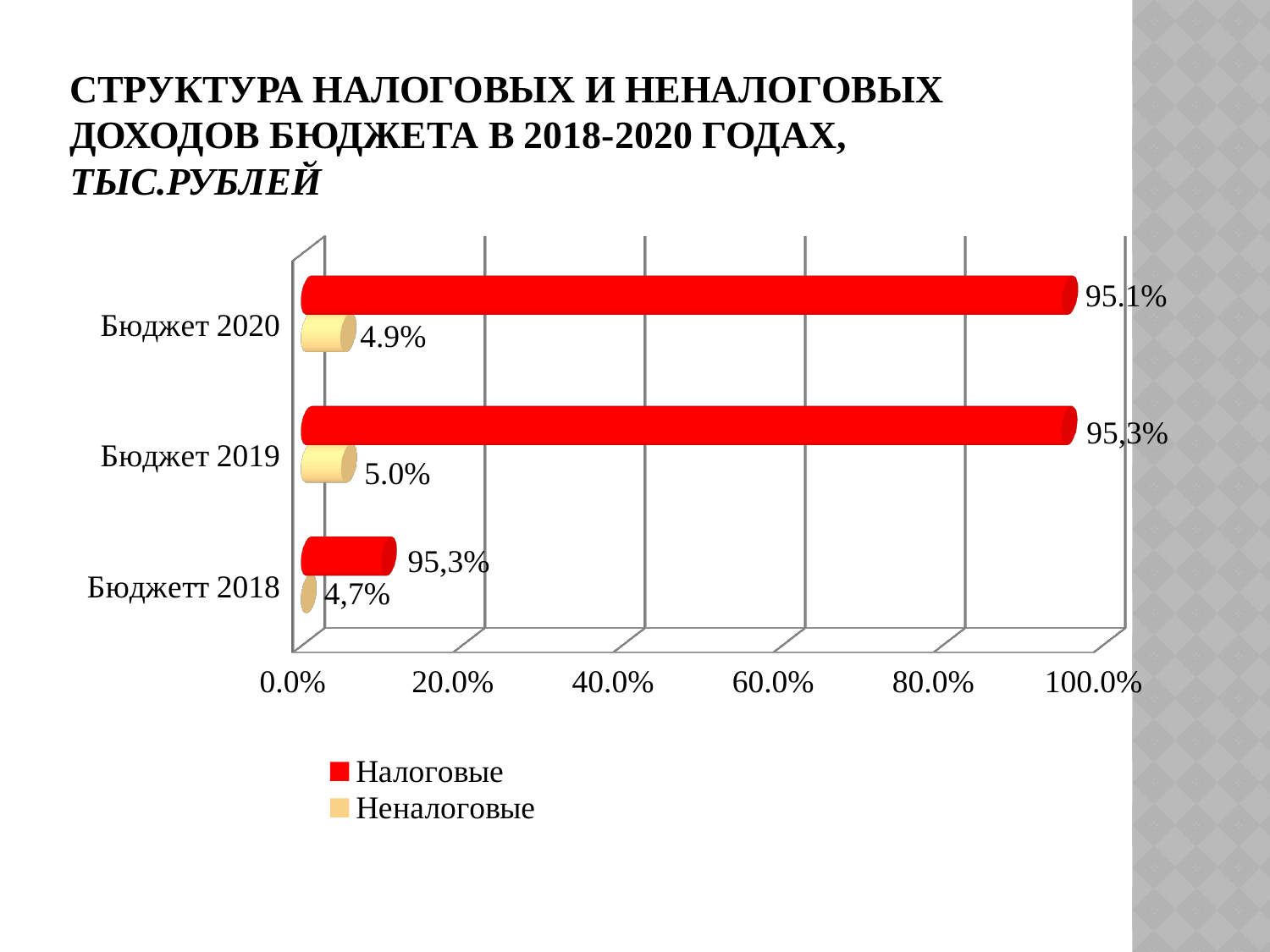
What is the difference between the Налоговые and Неналоговые values for Бюджет 2020? 90.2% What is the value for Неналоговые in Бюджетт 2018? 4,7% Which category has the lowest value for Неналоговые? Бюджетт 2018 What is the value for Неналоговые in Бюджет 2019? 5.0% Which is larger in Бюджет 2019: Налоговые or Неналоговые? Налоговые What is the value for Налоговые in Бюджет 2019? 95,3% What is the value for Неналоговые in Бюджет 2020? 4.9% How many categories are shown on the chart? 3 Which category has the highest value for Неналоговые? Бюджет 2019 What is the value for Налоговые in Бюджет 2020? 95.1% How many series does the legend list? 2 What kind of chart is shown on the slide? Bar chart